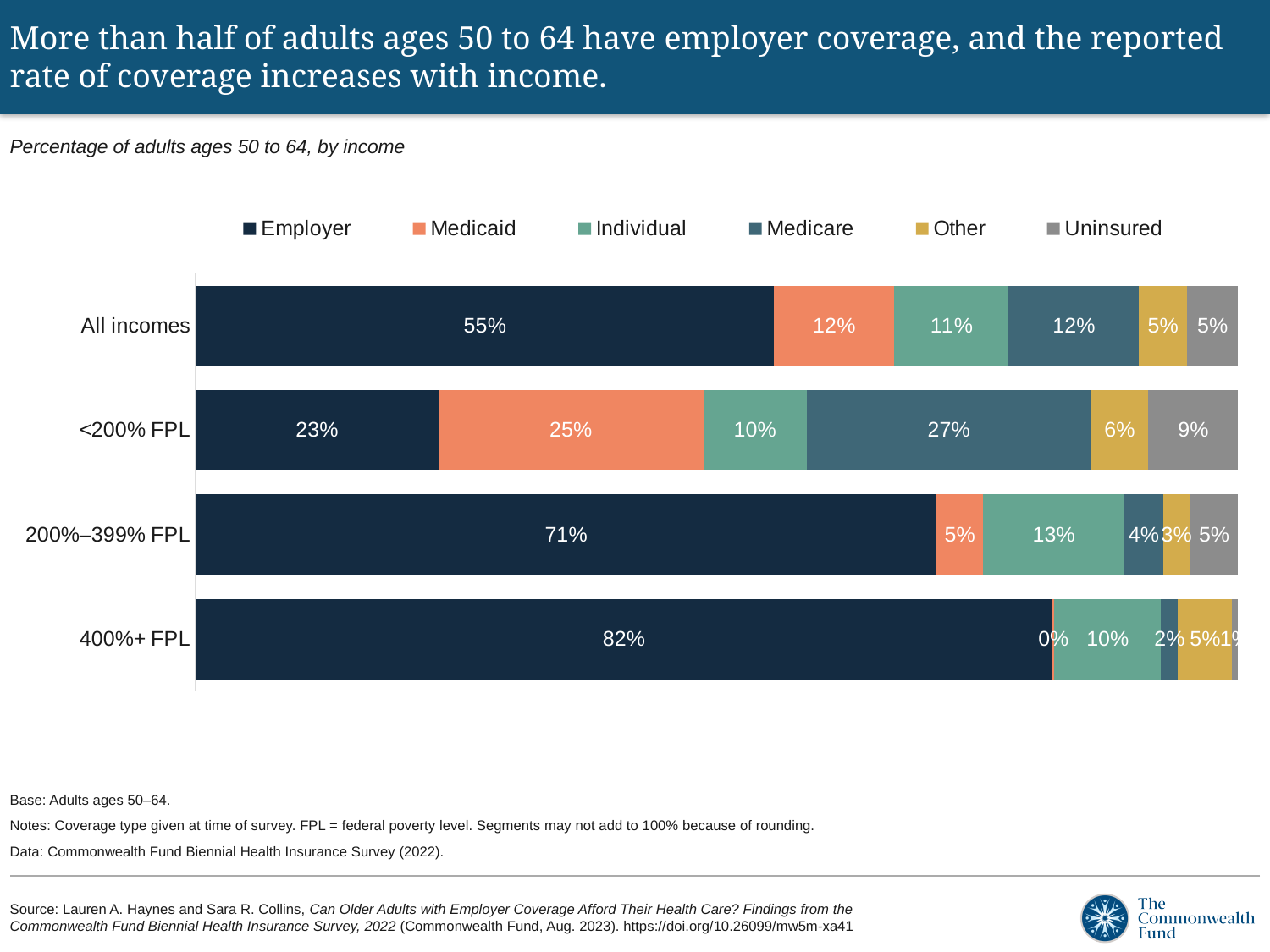
Which income group has the highest employer coverage rate? 400%+ FPL What type of chart is shown on the slide? Stacked bar chart How many coverage types does the legend list? 6 Which income group has the lowest employer coverage rate? <200% FPL Which coverage type is shown in orange in the legend? Medicaid Which is larger: the Medicare share for <200% FPL or the Medicare share for 200%–399% FPL? <200% FPL What is the Individual coverage share for the 400%+ FPL group? 10% What percentage of adults ages 50 to 64 with all incomes have employer coverage? 55% How many income groups are shown in the chart? 4 What is the Medicare share for the 200%–399% FPL group? 4% What is the difference in employer coverage between the 400%+ FPL group and the <200% FPL group? 59 percentage points What is the Medicaid share for adults in the <200% FPL income group? 25%